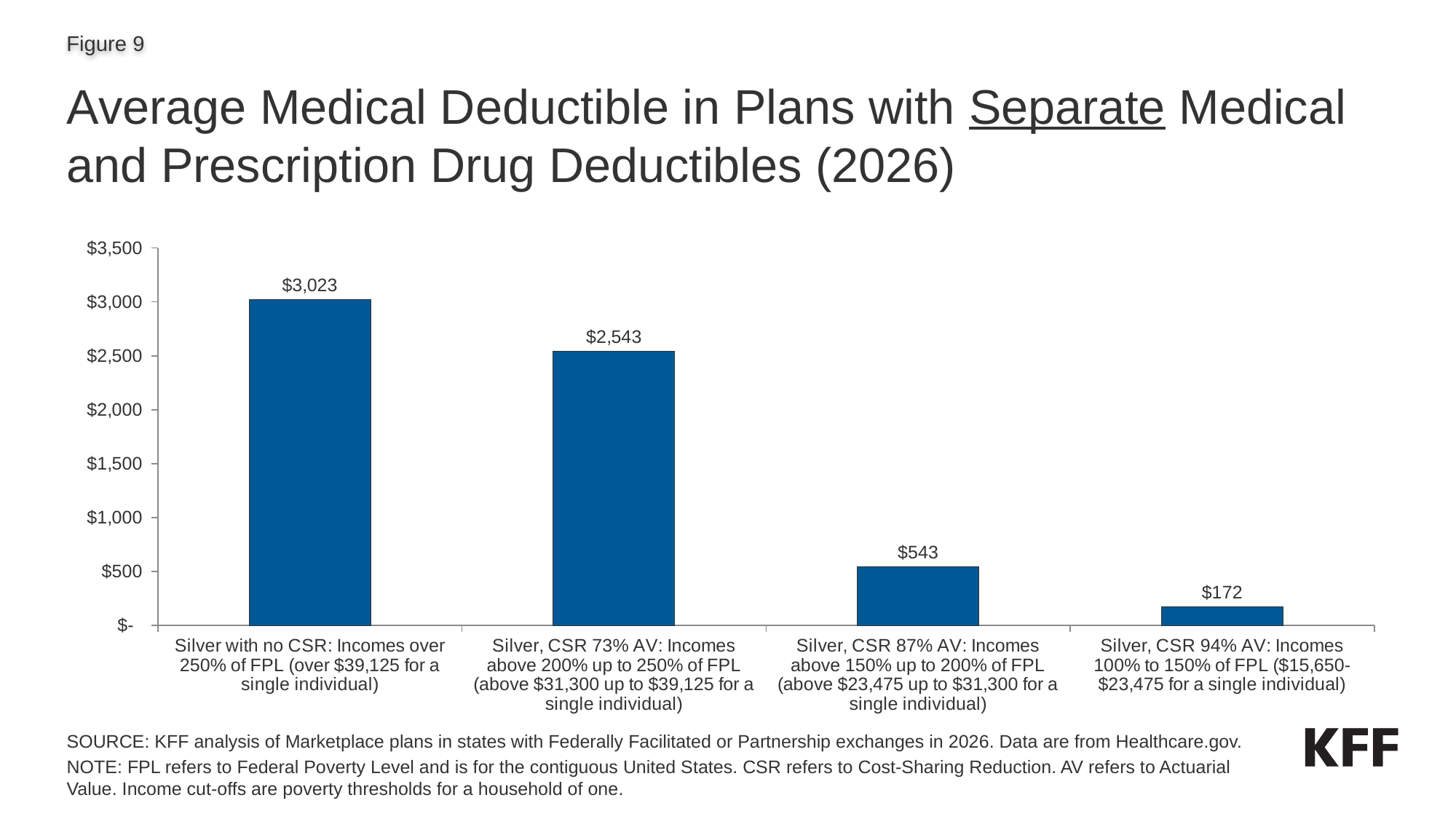
What kind of chart is shown on the slide? Bar chart Which plan category has the highest average medical deductible? Silver with no CSR What is the average medical deductible for Silver, CSR 87% AV plans? $543 What is the average medical deductible for Silver, CSR 73% AV plans? $2,543 What is the difference between the average medical deductible for Silver with no CSR and Silver, CSR 73% AV? $480 What is the average medical deductible for Silver, CSR 94% AV plans? $172 What is the average medical deductible for Silver plans with no CSR (incomes over 250% of FPL)? $3,023 Do the average medical deductibles rise or fall moving from left to right across the categories? Fall What is the difference between the average medical deductible for Silver, CSR 87% AV and Silver, CSR 94% AV? $371 Which plan category has the lowest average medical deductible? Silver, CSR 94% AV Which has a larger average medical deductible: Silver, CSR 73% AV or Silver, CSR 87% AV? Silver, CSR 73% AV How many plan categories are shown in the chart? 4